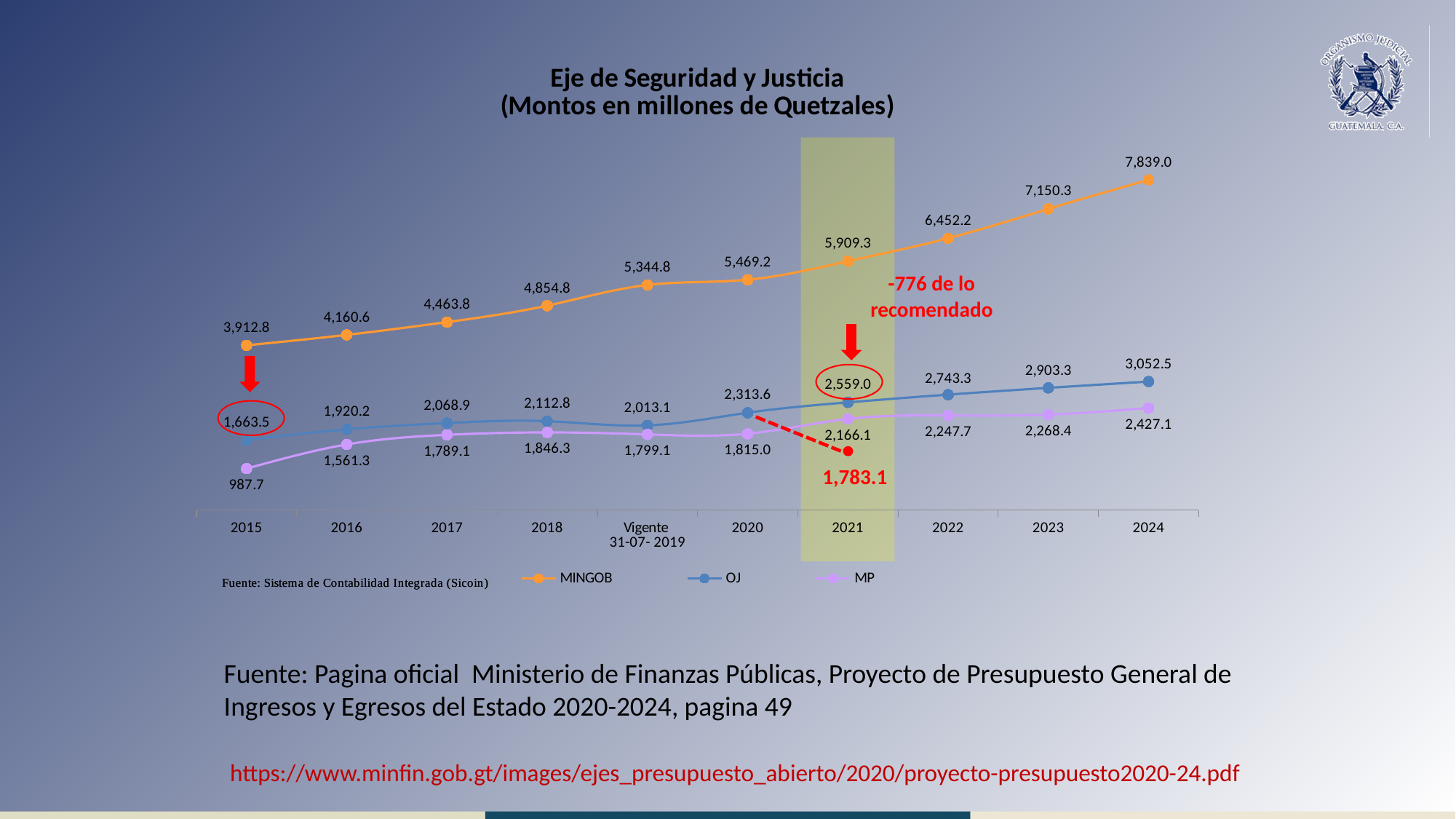
What is the MINGOB value for 2024? 7,839.0 What is the difference between the OJ values for 2024 and 2015? 1,389.0 What is the OJ value for 2021? 2,559.0 How many categories are shown on the x axis? 10 Does the MINGOB series rise or fall from 2015 to 2024? Rise What is the MP value for 2015? 987.7 How many series does the legend list? 3 Which series has the larger value in 2020, OJ or MP? OJ What is the difference between the MINGOB values for 2024 and 2023? 688.7 In which year is the MP series at its lowest value? 2015 What kind of chart is shown on the slide? Line chart In which year does the MINGOB series reach its highest value? 2024